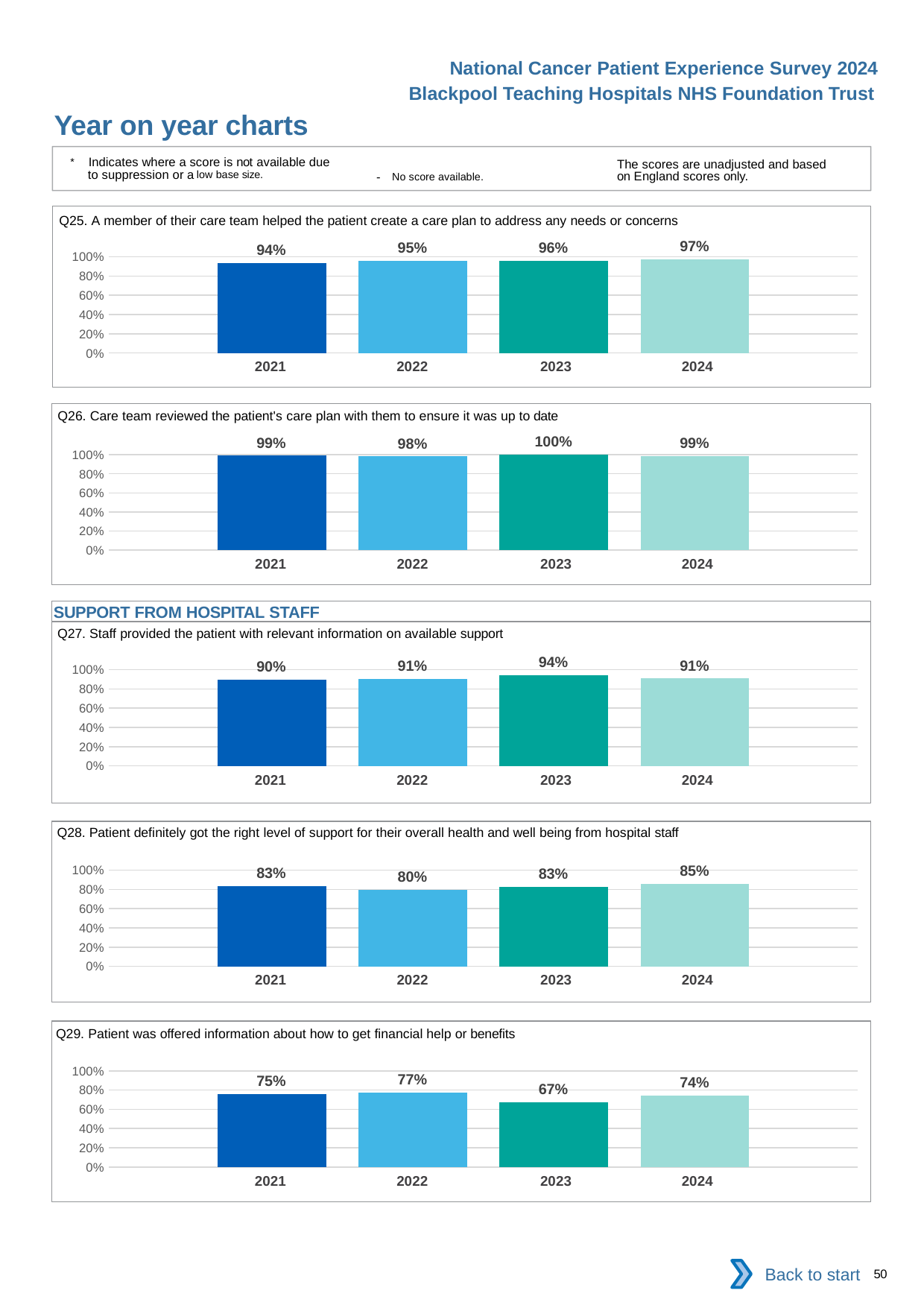
In the Q25 chart (care plan to address needs or concerns), what is the value for 2024? 97% How many years are shown on the x axis of the Q29 chart (information about financial help or benefits)? 4 In the Q28 chart (right level of support from hospital staff), which is larger, the 2024 value or the 2022 value? 2024 What kind of chart is the Q25 chart (care plan to address needs or concerns)? bar chart In the Q29 chart (information about financial help or benefits), what is the difference between the 2022 and 2023 values? 10 percentage points In the Q25 chart (care plan to address needs or concerns), do the values rise or fall from 2021 to 2024? rise In the Q26 chart (care team reviewed the care plan), which year has the highest value? 2023 In the Q27 chart (relevant information on available support), which year has the lowest value? 2021 In the Q28 chart (right level of support from hospital staff), what is the value for 2022? 80% In the Q27 chart (relevant information on available support), what is the difference between the 2023 and 2021 values? 4 percentage points In the Q26 chart (care team reviewed the care plan), what is the value for 2022? 98% In the Q29 chart (information about financial help or benefits), which year has the lowest value? 2023